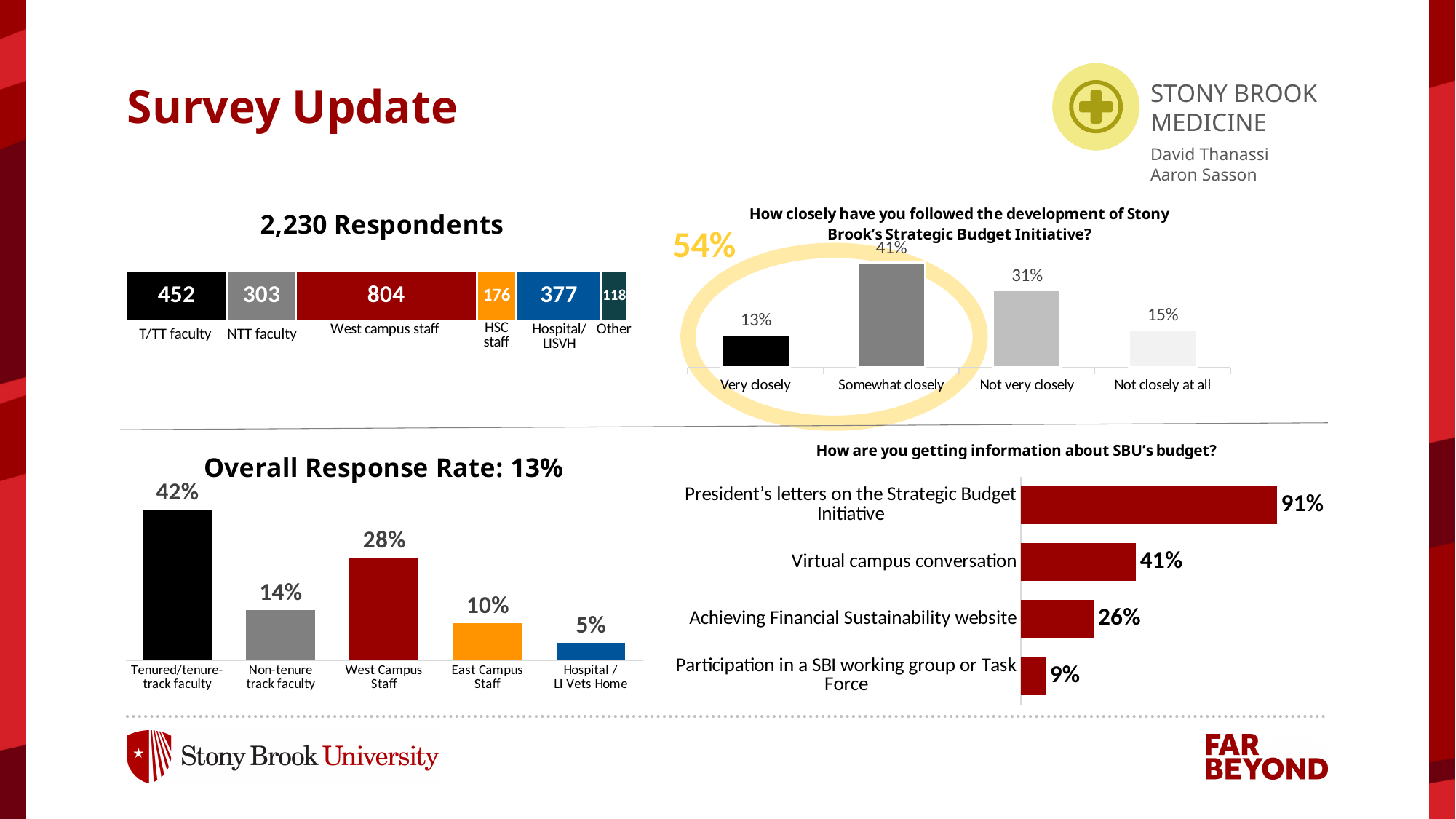
In the 'Overall Response Rate: 13%' chart, what is the response rate for West Campus Staff? 28% In the 'Overall Response Rate: 13%' chart, which group has the highest response rate? Tenured/tenure-track faculty In the '2,230 Respondents' chart, which group has the fewest respondents? Other In the 'How are you getting information about SBU's budget?' chart, what percentage cited the Achieving Financial Sustainability website? 26% What kind of chart is the 'How are you getting information about SBU's budget?' chart? Bar chart In the 'How closely have you followed the development of Stony Brook's Strategic Budget Initiative?' chart, what percentage answered 'Somewhat closely'? 41% In the '2,230 Respondents' chart, how many more T/TT faculty respondents are there than NTT faculty respondents? 149 In the 'Overall Response Rate: 13%' chart, what is the difference between the response rates of East Campus Staff and Hospital / LI Vets Home? 5% In the '2,230 Respondents' chart, how many respondents are West campus staff? 804 In the 'How are you getting information about SBU's budget?' chart, which source has the highest percentage? President's letters on the Strategic Budget Initiative In the 'How closely have you followed the development of Stony Brook's Strategic Budget Initiative?' chart, which response has the lowest percentage? Very closely In the 'How closely have you followed the development of Stony Brook's Strategic Budget Initiative?' chart, how many response categories are shown? 4